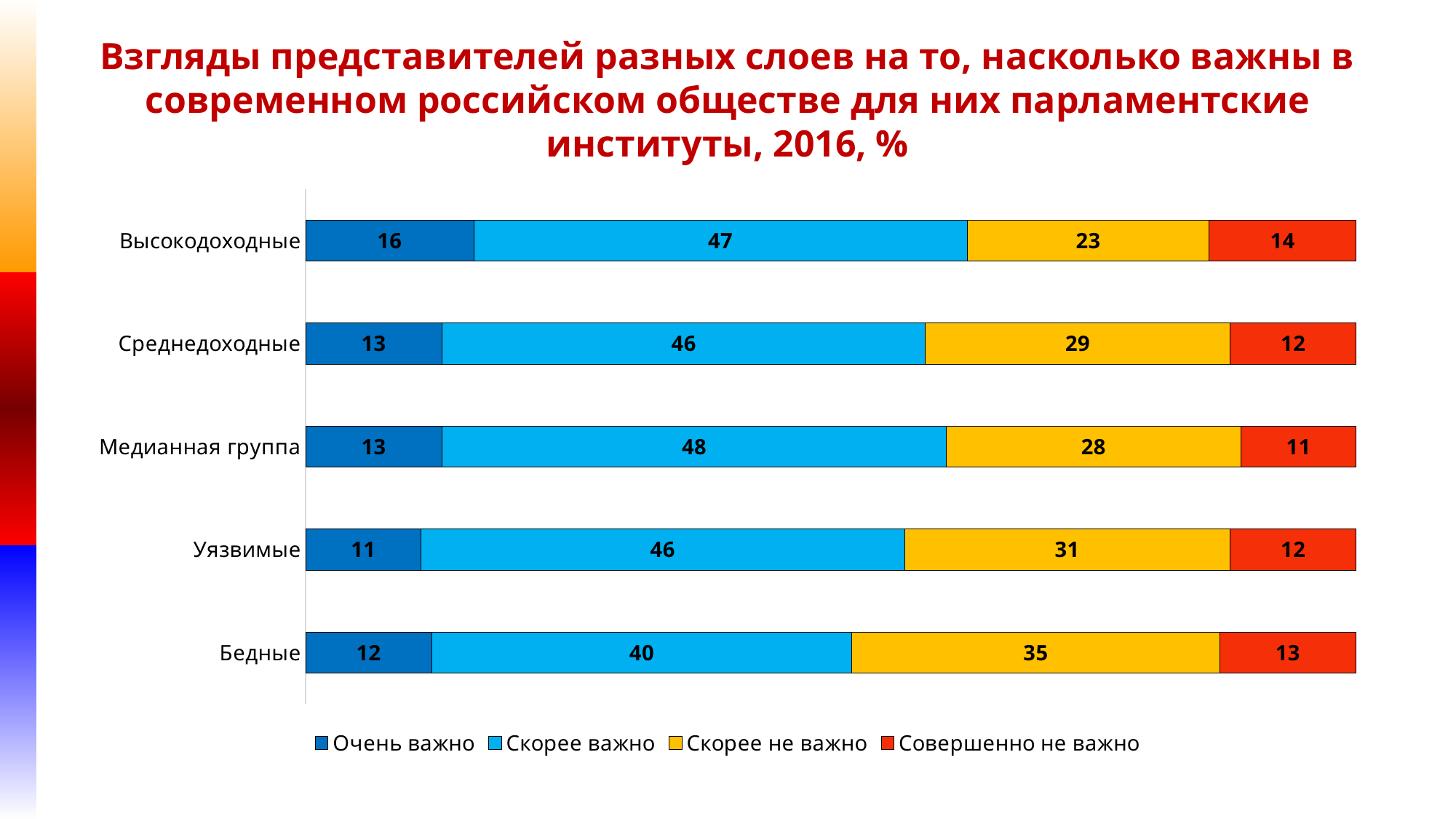
Which legend entry is shown in yellow? Скорее не важно What is the difference between the "Скорее не важно" values for Бедные and Высокодоходные? 12 Which is larger: the "Скорее важно" value for Среднедоходные or for Бедные? Среднедоходные How many categories are shown on the chart? 5 Which category has the lowest value for "Очень важно"? Уязвимые What is the value of "Очень важно" for Высокодоходные? 16 What is the value of "Совершенно не важно" for Медианная группа? 11 What is the value of "Скорее не важно" for Бедные? 35 What kind of chart is shown on the slide? Stacked bar chart How many series does the legend list? 4 Which category has the highest value for "Скорее важно"? Медианная группа What is the total of the stacked bar for Уязвимые? 100